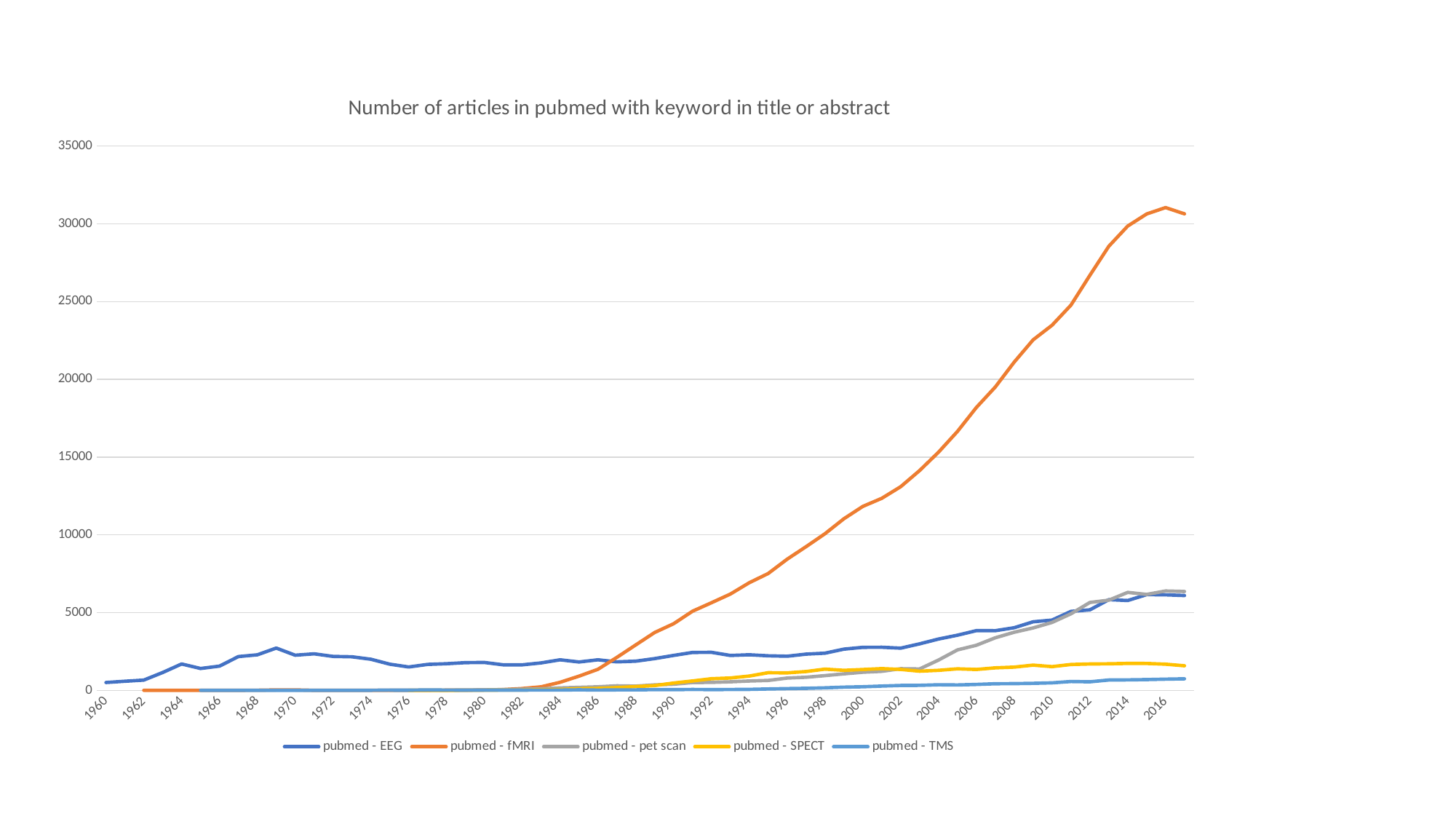
How many series does the legend list? 5 Is the value for pubmed - fMRI in 2010 greater or less than 20000? greater What is the title of the chart? Number of articles in pubmed with keyword in title or abstract What kind of chart is shown on the slide? line chart Which series has the lowest value in 2016? pubmed - TMS Which series has the highest value in 2016? pubmed - fMRI Which is larger in 2016, the value for pubmed - fMRI or the value for pubmed - EEG? pubmed - fMRI Is the value for pubmed - EEG in 1970 greater or less than 5000? less Is the value for pubmed - fMRI in 2016 greater or less than 30000? greater Does the pubmed - fMRI series generally rise or fall from 1986 to 2014? rise